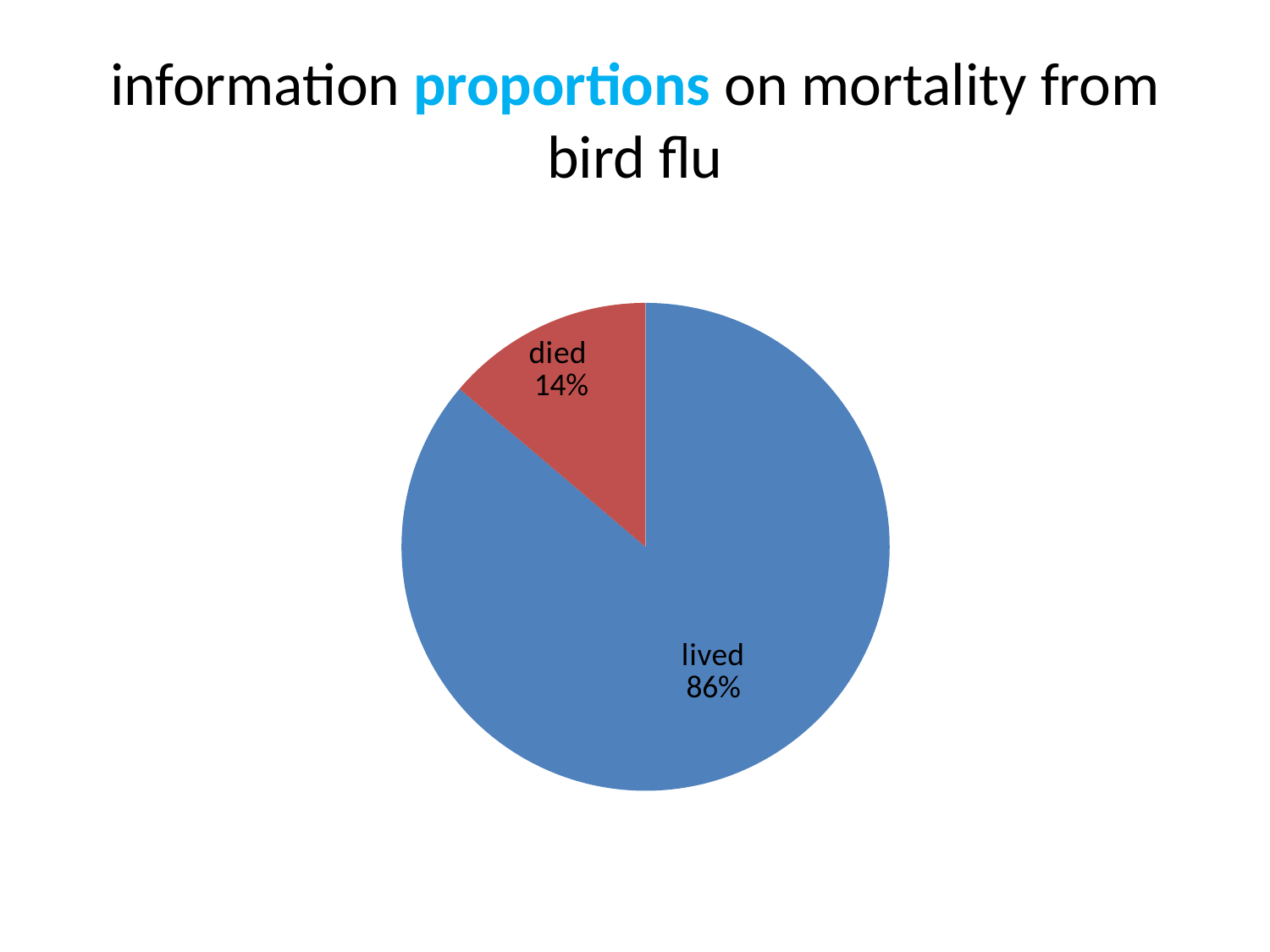
Which is larger, the "lived" slice or the "died" slice? lived What colour is the "died" slice? red What share of the pie does the "died" slice represent? 14% How many slices does the pie chart have? 2 Which slice of the pie is the smallest? died What percentage of the pie is labelled "died"? 14% What colour is the "lived" slice? blue What is the difference in percentage points between the "lived" and "died" slices? 72 Which slice of the pie is the largest? lived What type of chart is shown on the slide? pie chart What percentage of the pie is labelled "lived"? 86%